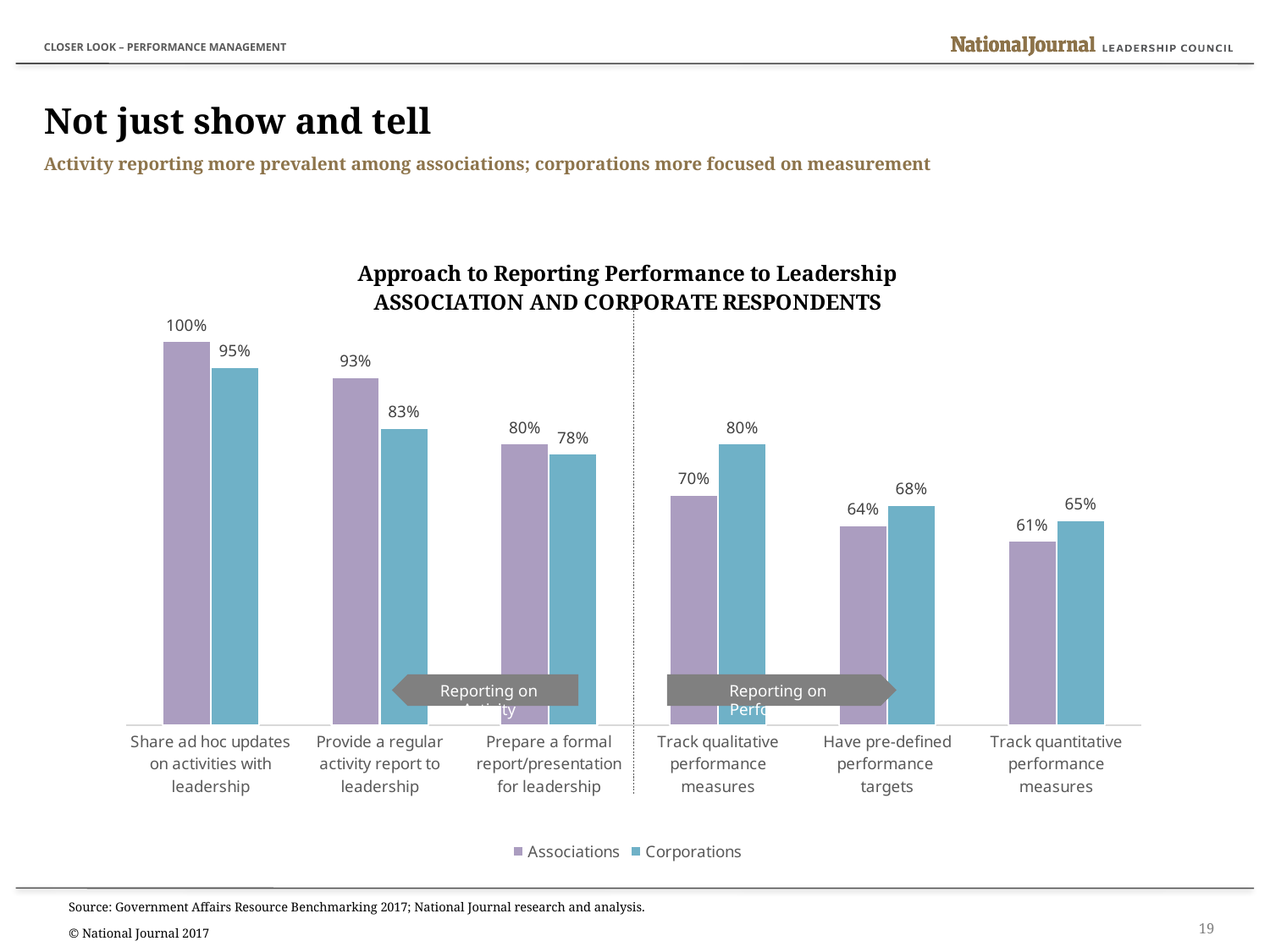
What are the two series named in the legend? Associations and Corporations How many series does the legend list? 2 What is the Corporations value for "Track qualitative performance measures"? 80% Which category has the highest Associations value? Share ad hoc updates on activities with leadership What is the Corporations value for "Provide a regular activity report to leadership"? 83% What is the Associations value for "Share ad hoc updates on activities with leadership"? 100% What is the difference between the Associations and Corporations values for "Provide a regular activity report to leadership"? 10 percentage points For "Have pre-defined performance targets", which is larger: the Associations value or the Corporations value? Corporations Which category has the lowest Corporations value? Track quantitative performance measures What kind of chart is shown on the slide? Bar chart What is the Associations value for "Track quantitative performance measures"? 61% How many categories are shown on the x axis? 6